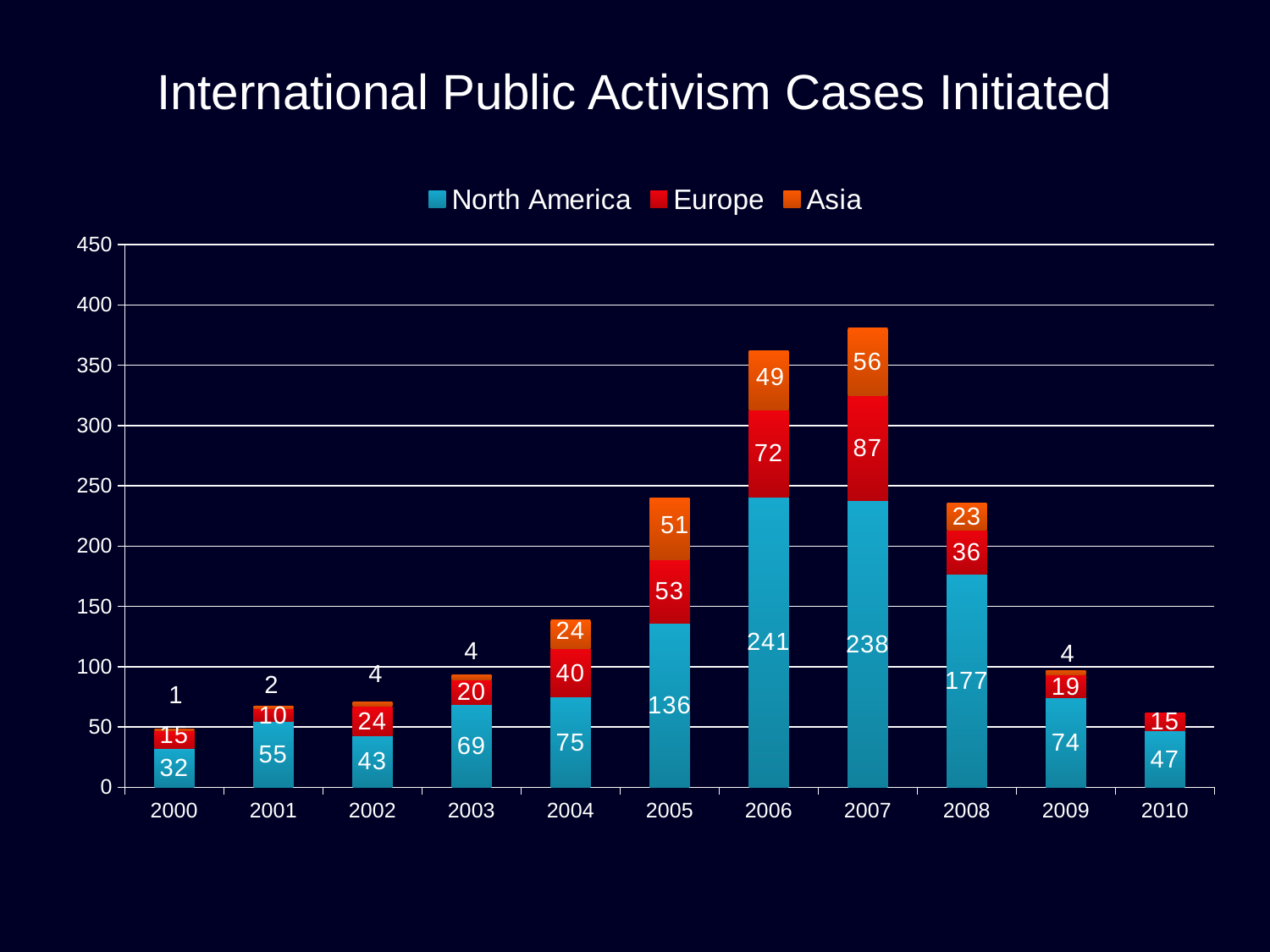
Which year has the highest Europe value? 2007 How many years are shown on the x axis? 11 How many series does the legend list? 3 What is the Asia value for 2005? 51 What is the Europe value for 2007? 87 What kind of chart is shown on the slide? Stacked bar chart Which is larger, the North America value for 2006 or for 2007? 2006 What is the total of the stacked bar for 2007? 381 What is the difference between the Europe values for 2007 and 2006? 15 Which year has the lowest North America value? 2000 What is the North America value for 2006? 241 What is the total of the stacked bar for 2005? 240